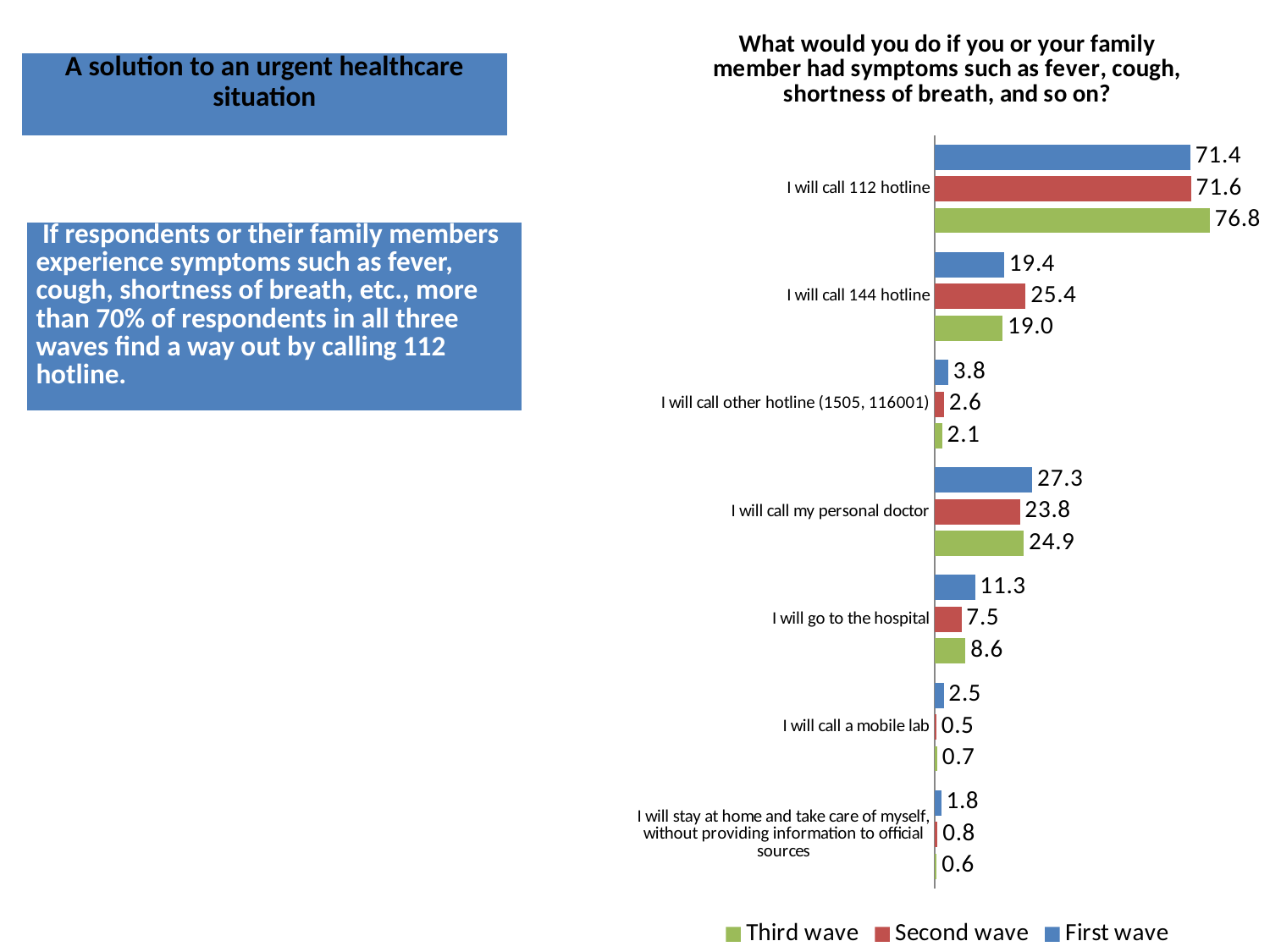
For "I will go to the hospital", which is larger: the First wave value or the Second wave value? First wave How many response categories are shown in the chart? 7 What type of chart is shown on the slide? Bar chart What is the difference between the Third wave and First wave values for "I will call 112 hotline"? 5.4 Which category has the lowest Third wave value? I will stay at home and take care of myself, without providing information to official sources What is the Second wave value for "I will call 144 hotline"? 25.4 What is the Second wave value for "I will call a mobile lab"? 0.5 Which category has the highest First wave value? I will call 112 hotline How many series does the legend list? 3 Which colour represents the Second wave series in the chart? Red What is the Third wave value for "I will call 112 hotline"? 76.8 What is the First wave value for "I will call my personal doctor"? 27.3